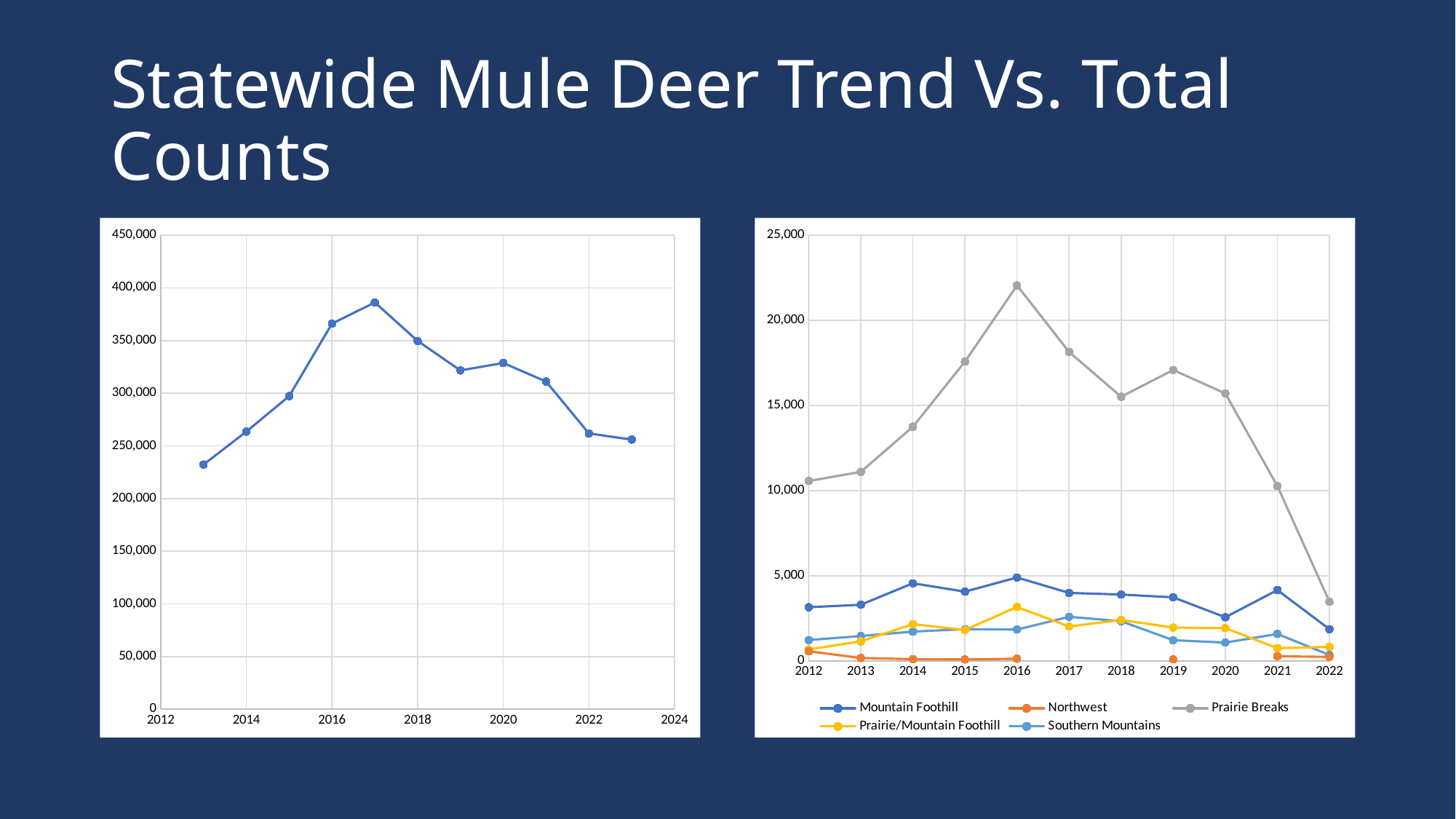
In the chart on the left, is the value for 2013 greater or less than 250,000? less In the chart on the right, is the value for Prairie Breaks in 2016 greater or less than 20,000? greater In the chart on the left, which is larger, the value for 2016 or the value for 2022? 2016 In the chart on the left, which year has the lowest value? 2013 In the chart on the right, how many years are shown on the x axis? 11 In the chart on the left, which year has the highest value? 2017 In the chart on the right, which series has the highest value in 2016? Prairie Breaks What kind of chart is the chart on the left of the slide? line chart In the chart on the left, do the values rise or fall from 2017 to 2023? fall In the chart on the right, is the value for Prairie Breaks in 2022 greater or less than 5,000? less How many series does the legend of the chart on the right list? 5